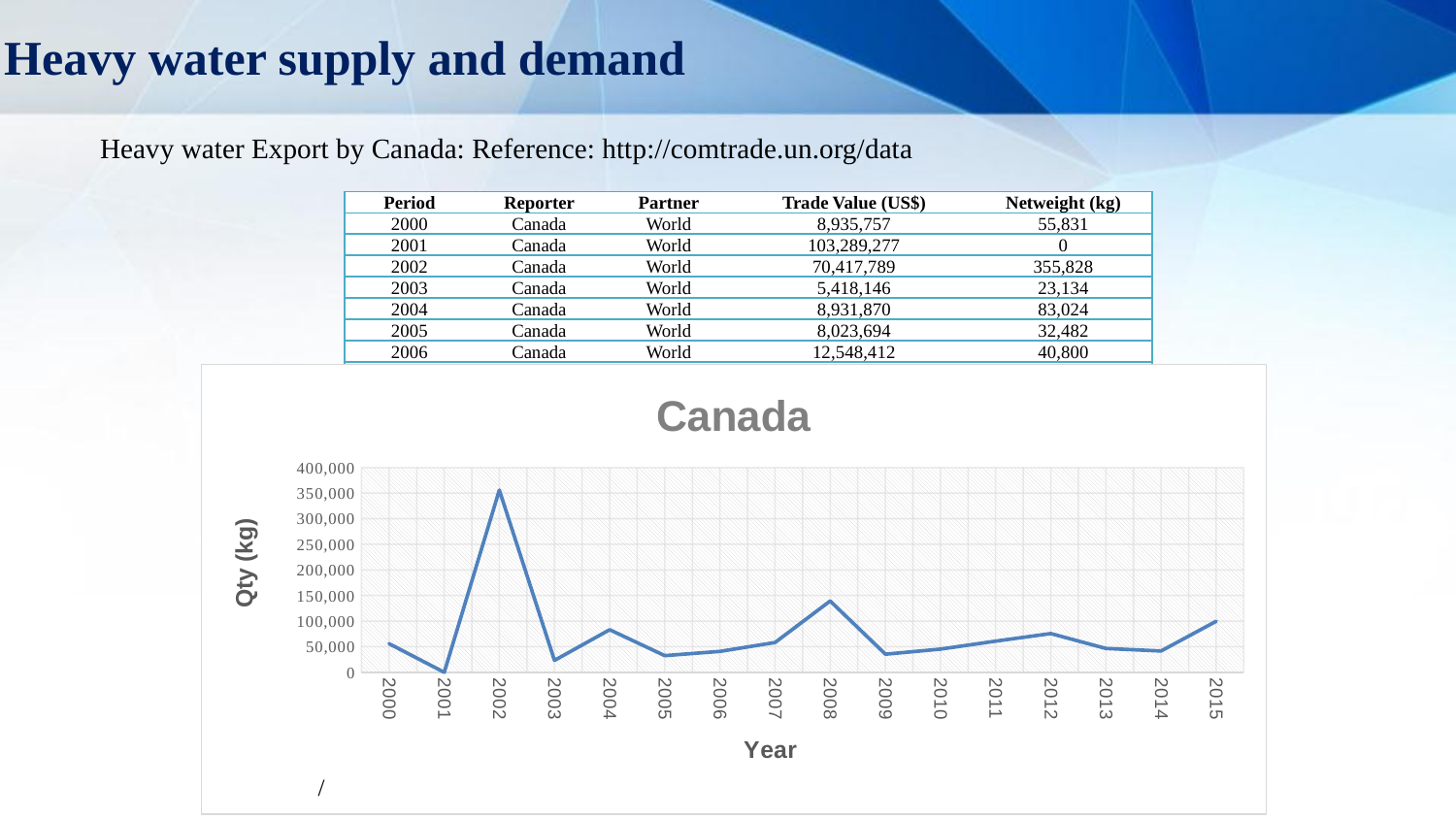
According to the table on the slide, what is the Netweight (kg) for Canada in 2002, the peak year of the chart? 355,828 In the "Canada" chart, is the value for 2008 greater or less than 100,000? greater In the "Canada" chart, which year has the highest Qty (kg)? 2002 In the "Canada" chart, does the Qty (kg) rise or fall from 2002 to 2003? fall In the "Canada" chart, is the value for 2009 greater or less than 50,000? less In the "Canada" chart, is the value for 2010 greater or less than 100,000? less What kind of chart is the "Canada" chart on the slide? line chart In the "Canada" chart, which year has the larger Qty (kg), 2008 or 2015? 2008 In the "Canada" chart, which year has the lowest Qty (kg)? 2001 How many years are plotted along the x axis of the "Canada" chart? 16 What is the label of the y axis of the "Canada" chart? Qty (kg)